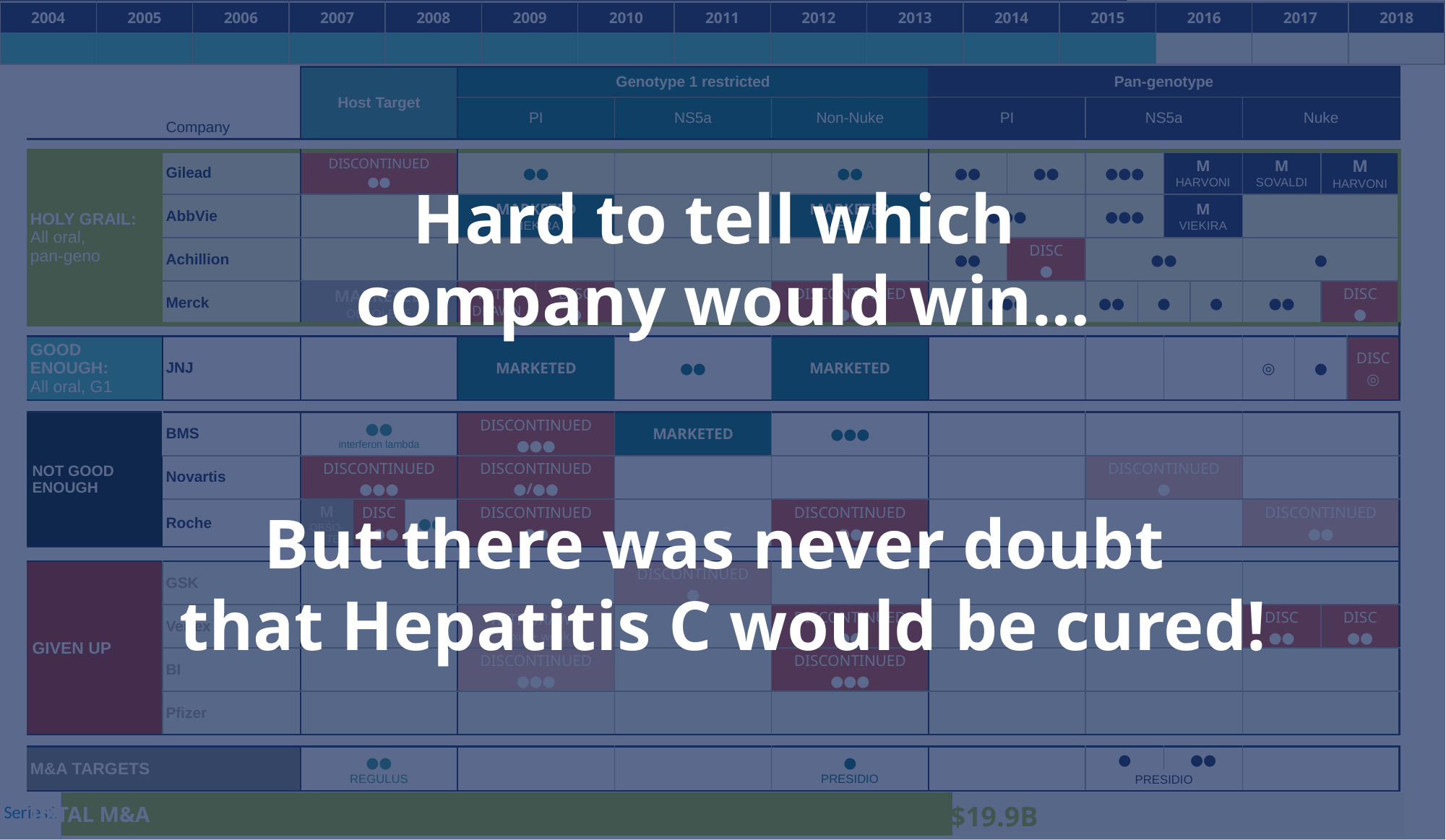
What kind of chart is shown at the bottom of the slide next to the TOTAL M&A label? bar chart How many bars does the chart at the bottom of the slide contain? 1 What colour is the bar in the chart at the bottom of the slide? green What series name is printed at the left of the bar chart at the bottom of the slide? Series1 On the bar chart at the bottom of the slide, what value is printed at the end of the TOTAL M&A bar? $19.9B